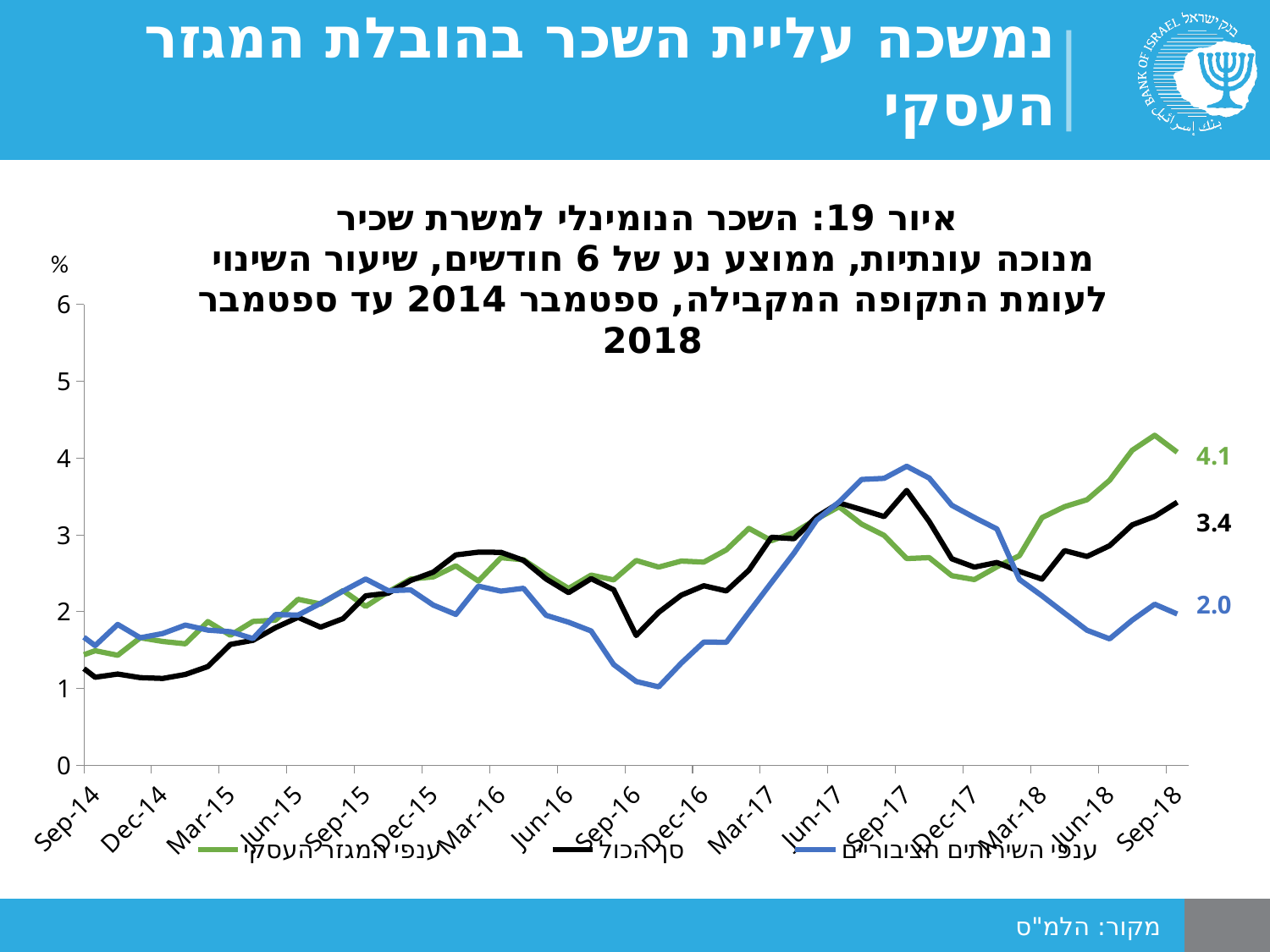
Which series has the lowest value at Sep-18? ענפי השירותים הציבוריים What is the value labelled at the end of the ענפי המגזר העסקי (green) line at Sep-18? 4.1 What is the value labelled at the end of the סך הכול (black) line at Sep-18? 3.4 What is the difference between the ענפי המגזר העסקי value and the סך הכול value at Sep-18? 0.7 What is the value labelled at the end of the ענפי השירותים הציבוריים (blue) line at Sep-18? 2.0 Which series has the highest value at Sep-18? ענפי המגזר העסקי Is the value of the ענפי השירותים הציבוריים (blue) line at Sep-16 greater or less than 2? less How many series does the legend list? 3 What kind of chart is shown on the slide? line chart What unit is shown on the vertical axis of the chart? % Does the ענפי השירותים הציבוריים (blue) line rise or fall between Sep-17 and Jun-18? fall What is the difference between the ענפי המגזר העסקי value and the ענפי השירותים הציבוריים value at Sep-18? 2.1